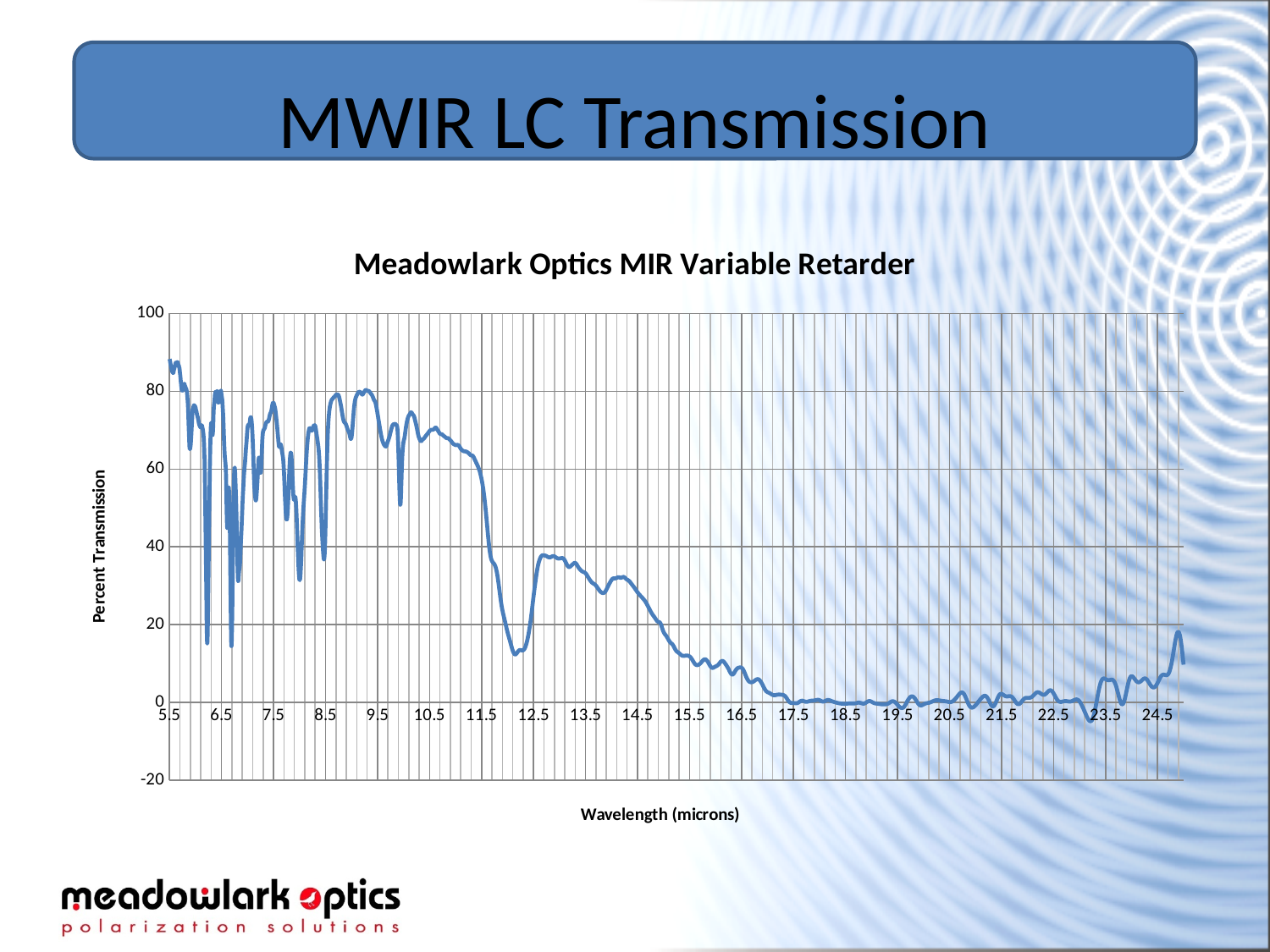
Overall, does the percent transmission rise or fall as wavelength increases from 5.5 to 24.5 microns? fall Which wavelength has the higher percent transmission, 8.5 microns or 15.5 microns? 8.5 microns Which wavelength has the higher percent transmission, 10.5 microns or 18.5 microns? 10.5 microns What is the title of the chart? Meadowlark Optics MIR Variable Retarder Is the percent transmission at 18.5 microns greater or less than 20? less What is the label of the vertical axis of the chart? Percent Transmission Is the percent transmission at 12.5 microns greater or less than 20? greater Is the percent transmission at 10.5 microns greater or less than 60? greater What kind of chart is shown on the slide? line chart